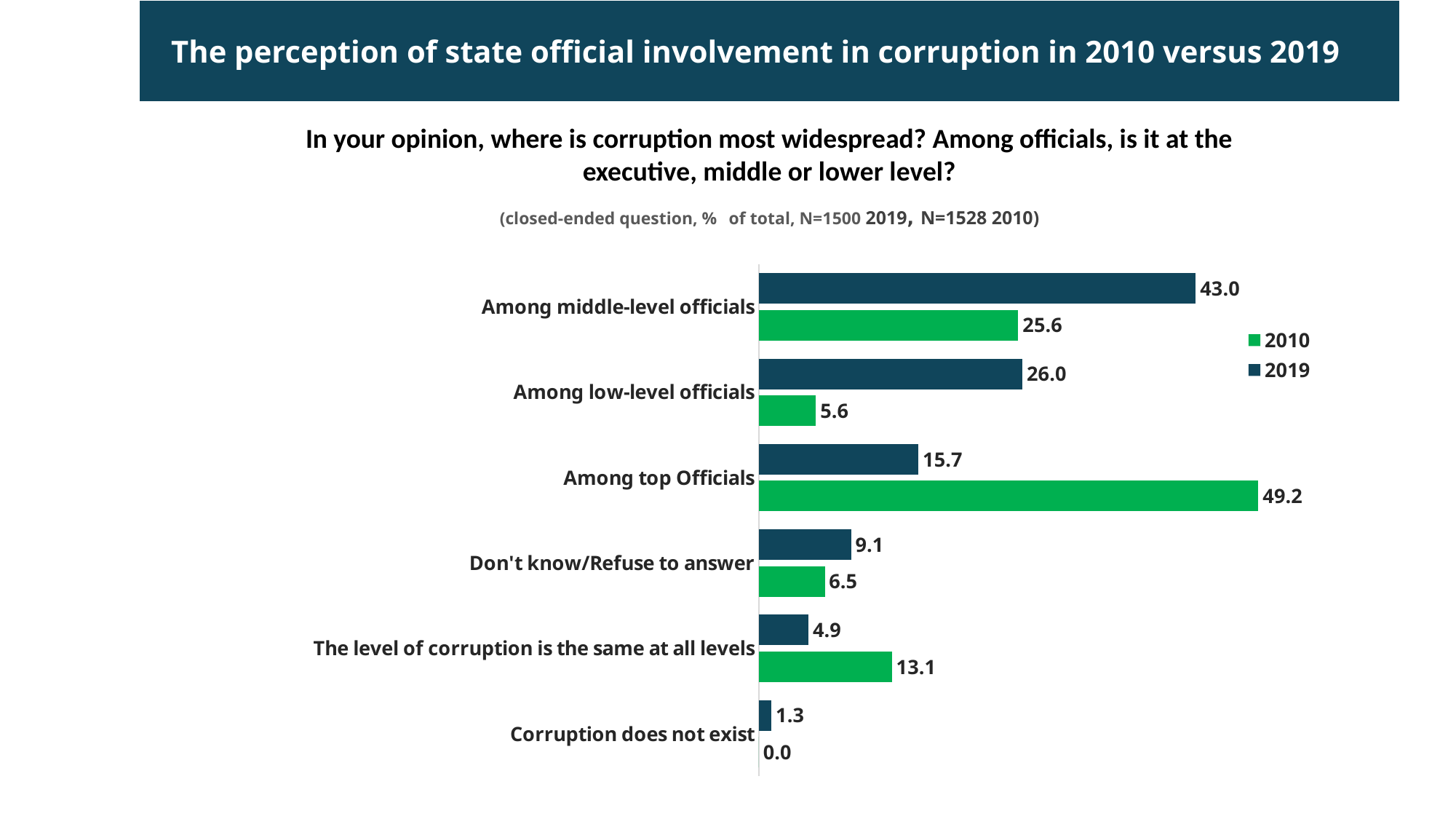
For "Don't know/Refuse to answer", which year has the larger value, 2010 or 2019? 2019 Which category has the lowest 2010 value? Corruption does not exist What kind of chart is shown on the slide? Bar chart Which category has the highest 2019 value? Among middle-level officials What is the 2019 value for "The level of corruption is the same at all levels"? 4.9 What is the 2010 value for "Among top Officials"? 49.2 What is the difference between the 2010 and 2019 values for "Among top Officials"? 33.5 How many categories are shown on the chart? 6 What is the 2010 value for "Among low-level officials"? 5.6 What is the difference between the 2019 and 2010 values for "Among middle-level officials"? 17.4 How many series does the legend list? 2 What is the 2019 value for "Among middle-level officials"? 43.0